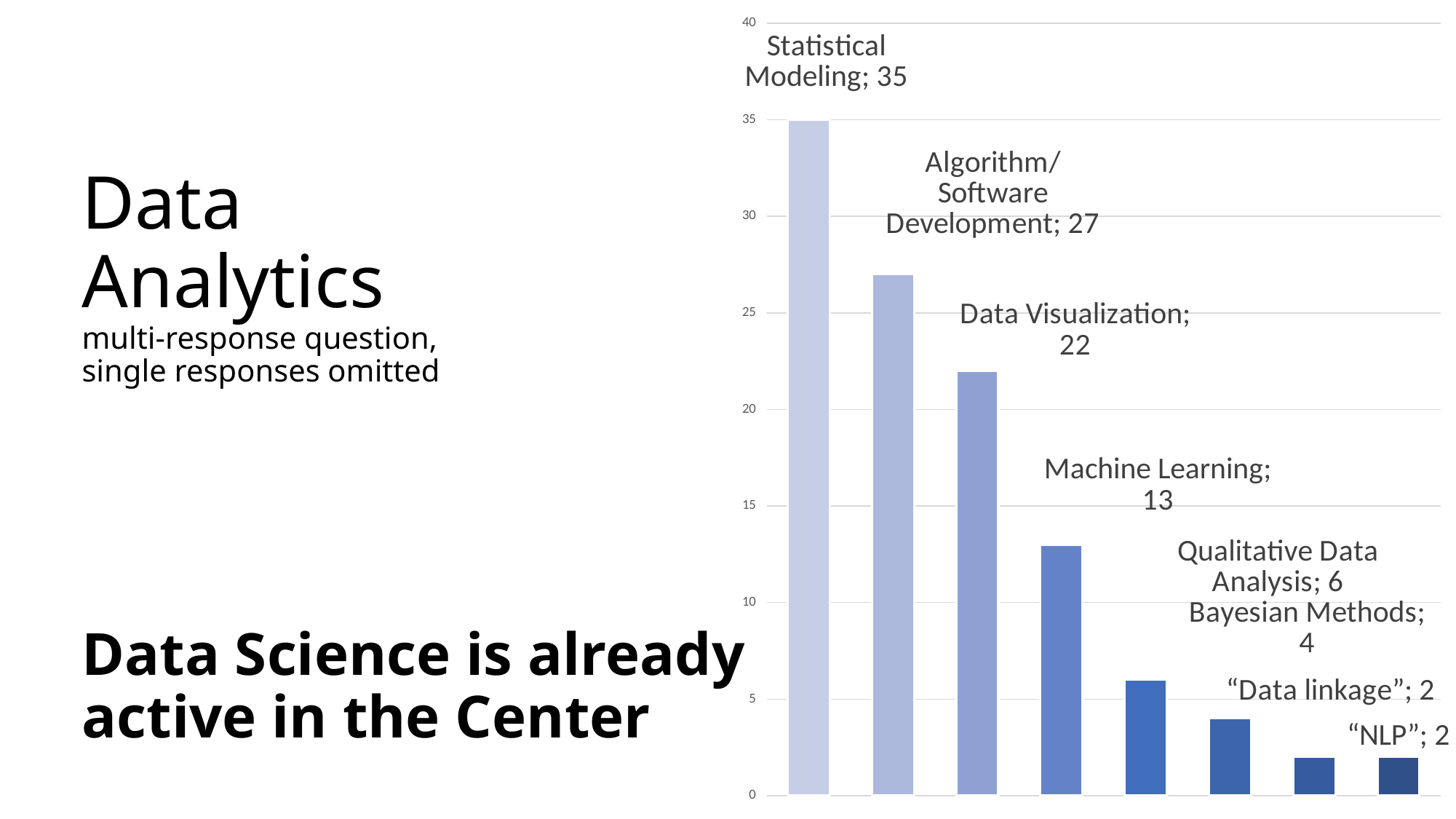
What is the value for Machine Learning? 13 What is the difference between the values for Statistical Modeling and Data Visualization? 13 What is the value for Statistical Modeling? 35 What is the difference between the values for Machine Learning and Qualitative Data Analysis? 7 Do the values rise or fall from left to right across the bars? Fall How many categories (bars) are shown in the chart? 8 Which is larger, the value for Data Visualization or the value for Machine Learning? Data Visualization What kind of chart is shown on the slide? Bar chart What is the value for Algorithm/Software Development? 27 What is the value for Bayesian Methods? 4 Which category has the highest value? Statistical Modeling What is the highest value shown on the vertical axis? 40